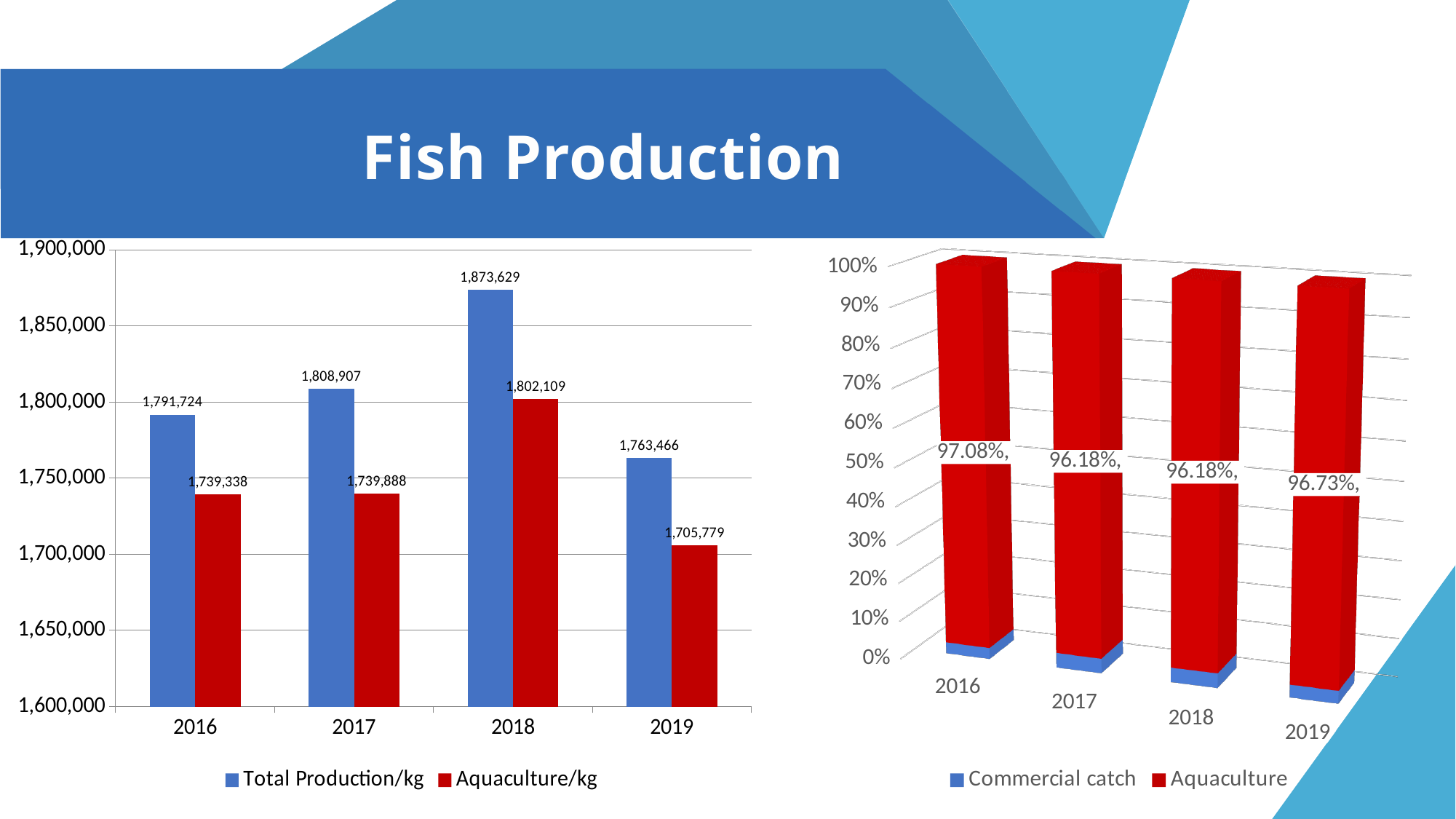
What kind of chart is the left chart? Bar chart In the right chart, which year has the highest Aquaculture share? 2016 In the left chart, what is the difference between Total Production/kg and Aquaculture/kg in 2016? 52,386 In the left chart, what is the Total Production/kg value for 2018? 1,873,629 In the left chart, what is the Aquaculture/kg value for 2019? 1,705,779 In the right chart, what is the Aquaculture share for 2016? 97.08% In the left chart, is Total Production/kg higher in 2017 or in 2019? 2017 In the left chart, which year has the lowest Aquaculture/kg? 2019 In the left chart, how many years are shown on the x axis? 4 In the left chart, how many series does the legend list? 2 In the left chart, which year has the highest Total Production/kg? 2018 In the right chart, what are the two series listed in the legend? Commercial catch and Aquaculture